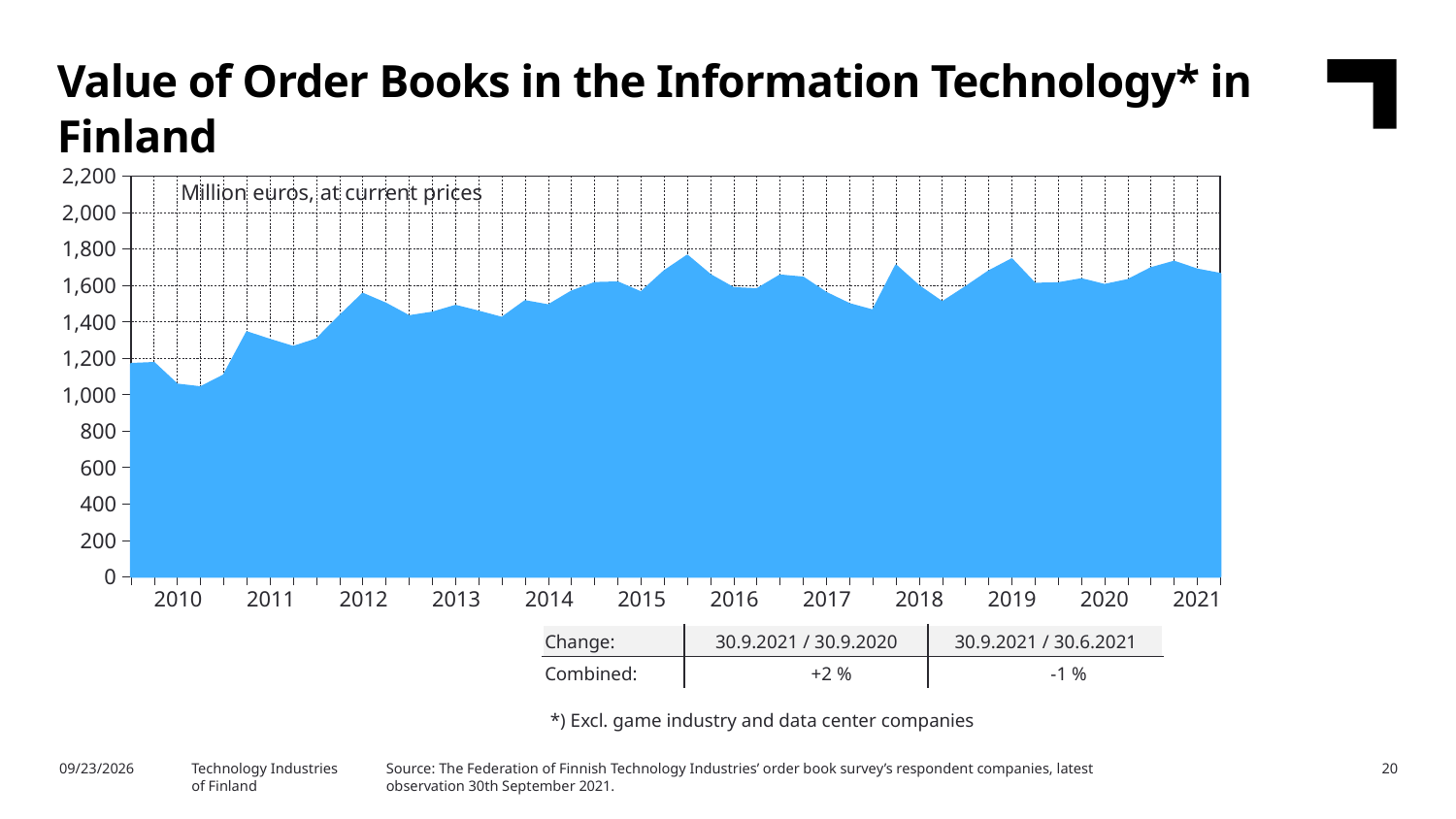
Overall, do the values of order books rise or fall from 2010 to 2021? rise How many years are labelled on the x axis of the chart? 12 What kind of chart is shown on the slide? Area chart Is the lowest value of order books in 2010 greater or less than 1,200? less What unit is the value of order books measured in, according to the label inside the chart? Million euros, at current prices Is the peak value of order books in 2019 greater or less than 1,600? greater Is the value of order books at the start of 2010 greater or less than 1,000? greater In which year does the chart show its lowest value of order books? 2010 What is the combined change in order books for 30.9.2021 / 30.6.2021 shown in the table below the chart? -1 % What is the combined change in order books for 30.9.2021 / 30.9.2020 shown in the table below the chart? +2 %